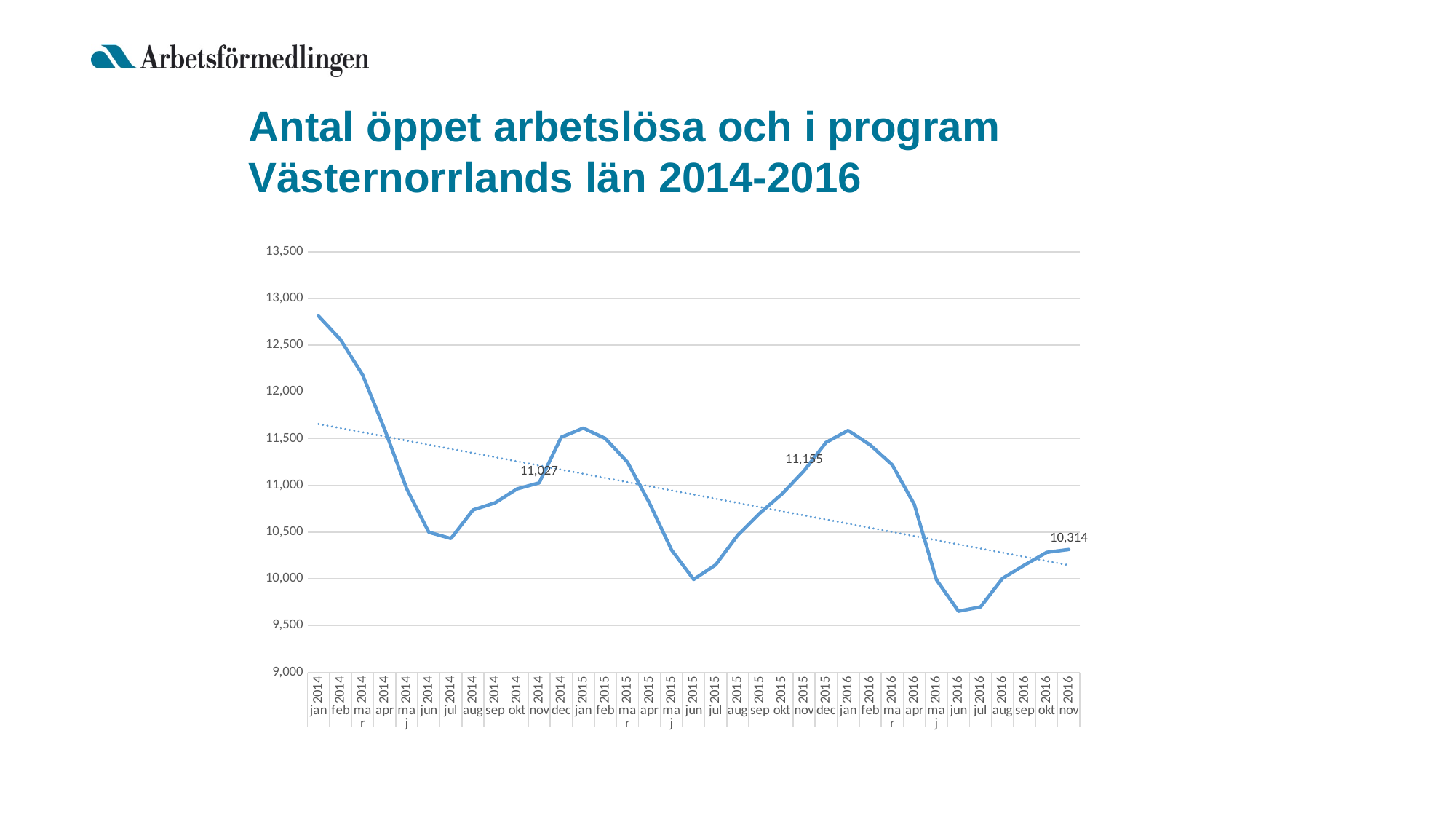
Which month has the lowest value on the chart? 2016 jun How many monthly data points are plotted on the chart? 35 What is the value for 2016 nov? 10,314 Which month has the highest value on the chart? 2014 jan What is the value for 2014 nov? 11,027 Is the value for 2014 jan greater or less than 12,500? greater What is the difference between the values for 2015 nov and 2016 nov? 841 What is the difference between the values for 2015 nov and 2014 nov? 128 Is the value for 2016 jun greater or less than 10,000? less What kind of chart is shown on the slide? line chart Which is larger, the value for 2015 nov or the value for 2016 nov? 2015 nov What is the value for 2015 nov? 11,155